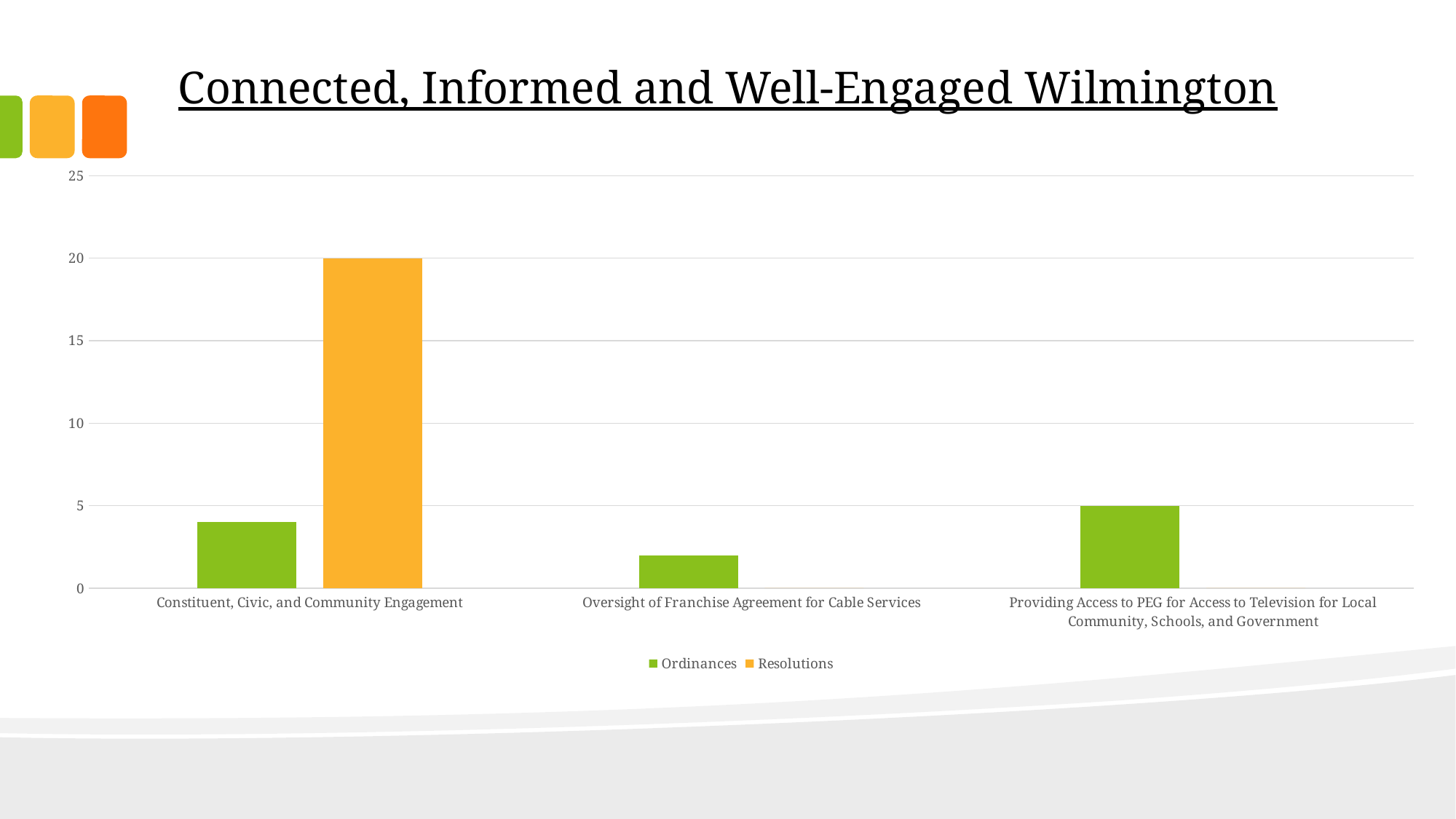
Which category has the highest Ordinances value? Providing Access to PEG for Access to Television for Local Community, Schools, and Government For Constituent, Civic, and Community Engagement, which is larger: Ordinances or Resolutions? Resolutions Which category has the lowest Ordinances value? Oversight of Franchise Agreement for Cable Services How many categories are shown on the x axis? 3 Is the Ordinances value for Oversight of Franchise Agreement for Cable Services greater or less than 5? less Which category has the highest Resolutions value? Constituent, Civic, and Community Engagement What kind of chart is shown on the slide? Bar chart Is the Ordinances value for Constituent, Civic, and Community Engagement greater or less than 5? less What is the difference between the Resolutions value for Constituent, Civic, and Community Engagement and the Ordinances value for Providing Access to PEG for Access to Television for Local Community, Schools, and Government? 15 What is the value of Ordinances for Providing Access to PEG for Access to Television for Local Community, Schools, and Government? 5 How many series does the legend list? 2 What is the value of Resolutions for Constituent, Civic, and Community Engagement? 20